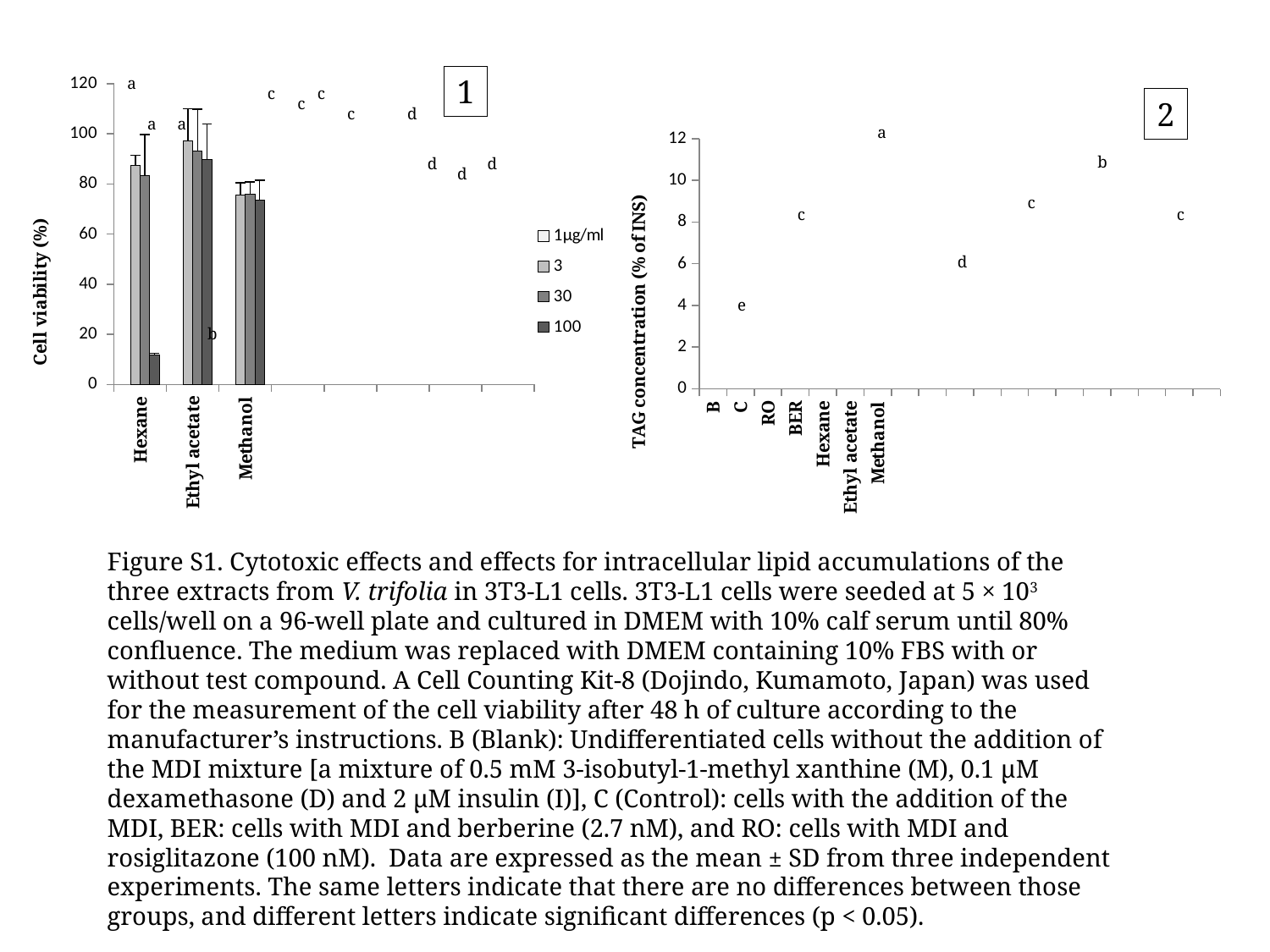
In chart 1 (Cell viability), which series has the lowest bar within the Hexane group? 100 How many labelled categories are shown on the x axis of chart 1 (Cell viability)? 3 In chart 1 (Cell viability), is the value for Hexane at 100 greater or less than 20? less How many series does the legend of chart 1 (Cell viability) list? 4 In chart 1 (Cell viability), is the value for Ethyl acetate at 1µg/ml greater or less than 80? greater In chart 1 (Cell viability), is the value for Hexane at 1µg/ml greater or less than 80? greater What kind of chart is chart 1 (Cell viability)? bar chart In chart 1 (Cell viability), which category has the lowest value for the 100 series? Hexane How many labelled categories are shown on the x axis of chart 2 (TAG concentration)? 7 In chart 1 (Cell viability), which is larger for Hexane: the 1µg/ml value or the 100 value? 1µg/ml What is the y-axis label of chart 2? TAG concentration (% of INS)